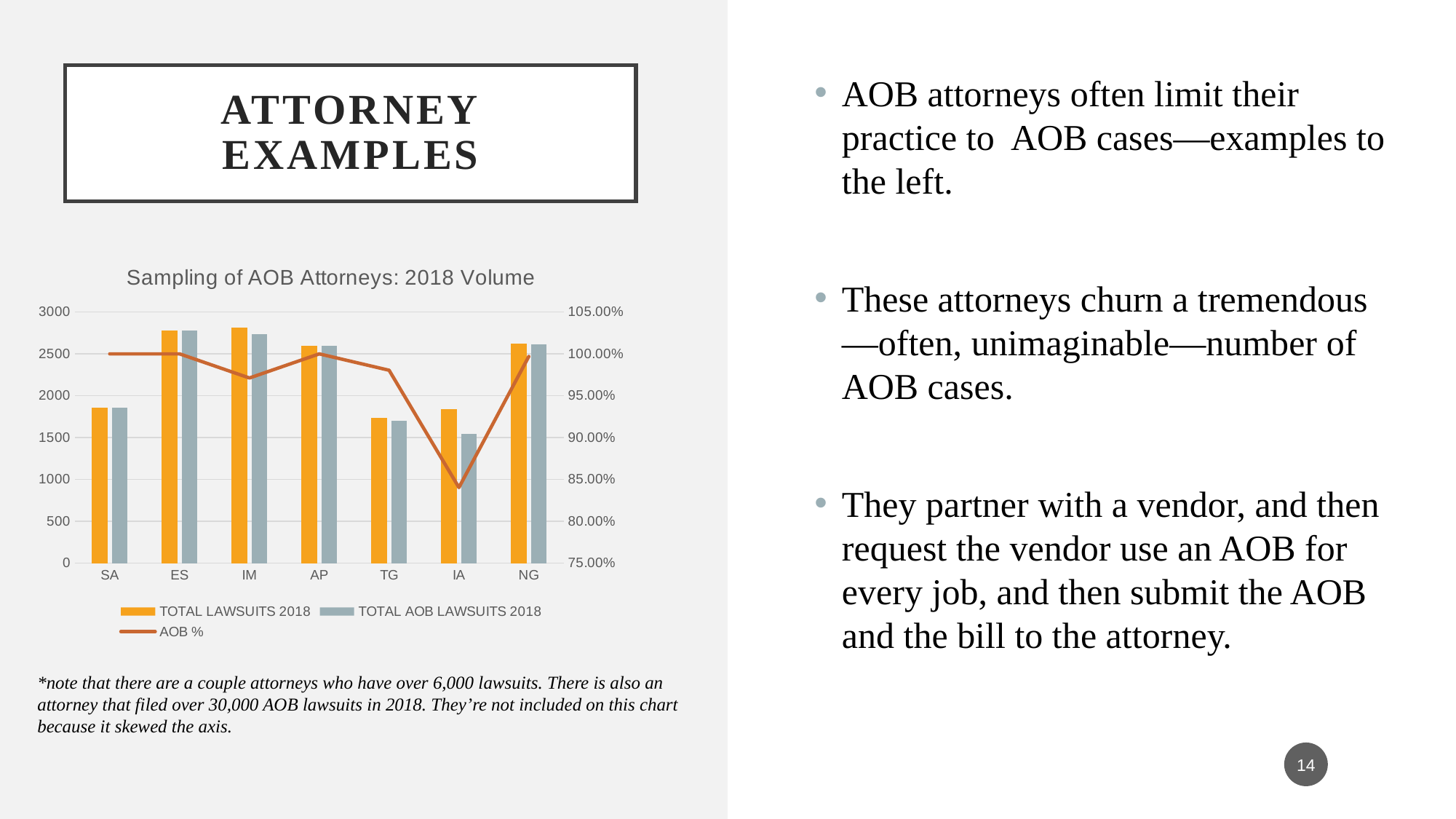
How many series does the chart legend list? 3 Which series is drawn as a line in the chart? AOB % Which attorney has the lowest TOTAL LAWSUITS 2018 value? TG What kind of chart is shown on the slide? A combined bar and line chart Which attorney has the lowest AOB % in the chart? IA Is the AOB % value for IA greater or less than 90.00%? less Is the TOTAL AOB LAWSUITS 2018 value for SA greater or less than 2000? less What is the title of the chart? Sampling of AOB Attorneys: 2018 Volume Which has the larger TOTAL LAWSUITS 2018 value, ES or SA? ES Is the TOTAL LAWSUITS 2018 value for ES greater or less than 2500? greater How many attorney categories are shown on the x axis of the chart? 7 Which attorney has the lowest TOTAL AOB LAWSUITS 2018 value? IA